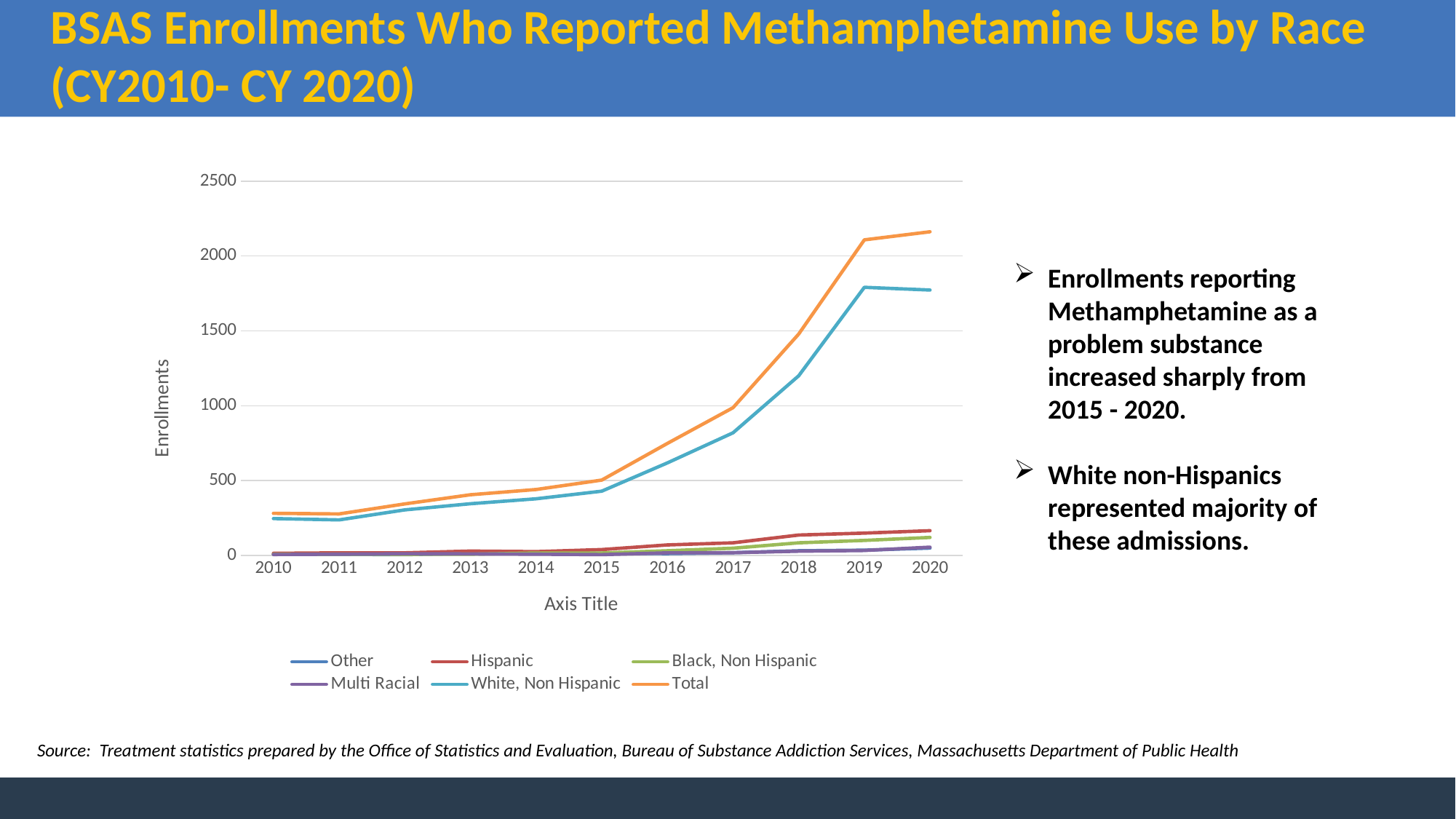
Excluding the Total line, which race category has the highest enrollments in 2019? White, Non Hispanic Which is larger in 2018, the value for White, Non Hispanic or the value for Hispanic? White, Non Hispanic Is the value for Total in 2010 greater or less than 500? less What kind of chart is shown on the slide? line chart Is the value for White, Non Hispanic in 2019 greater or less than 1500? greater How many series does the chart legend list? 6 Is the value for White, Non Hispanic in 2017 greater or less than 1000? less How many years are plotted along the x axis? 11 Does the Total line rise or fall from 2010 to 2020? rise What is the title of the vertical axis? Enrollments Which series has the highest value in 2020? Total